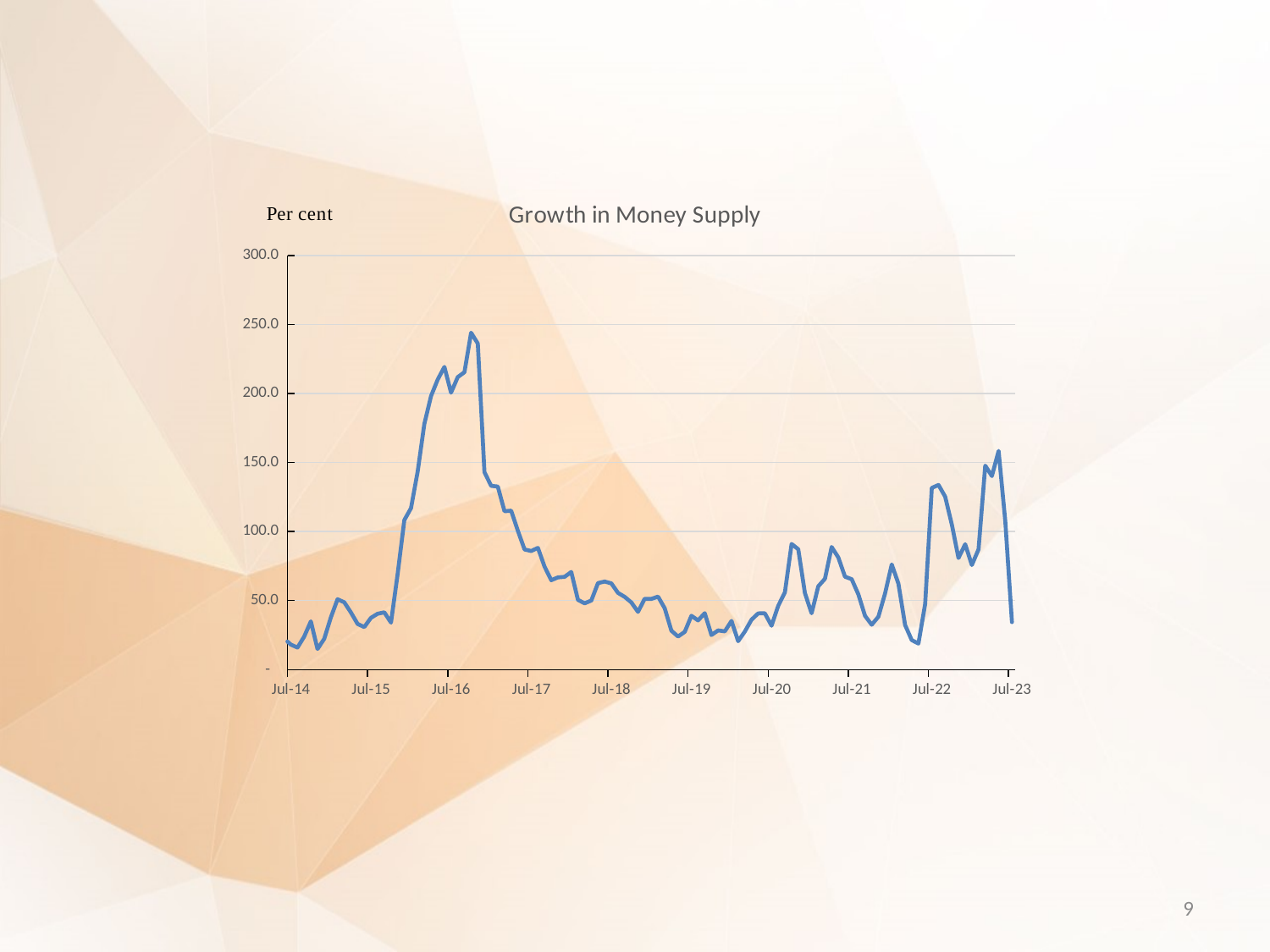
Is the value at Jul-19 greater or less than 50.0? less Is the highest point of the line greater or less than 250.0? less What is the title of the chart? Growth in Money Supply What kind of chart is shown on the slide? line chart Is the value at Jul-17 greater or less than 100.0? less What unit label is shown above the vertical axis of the chart? Per cent Which is larger, the value at Jul-16 or the value at Jul-22? Jul-16 Between which two x-axis labels does the line reach its highest point? Jul-16 and Jul-17 How many date labels are shown along the x axis of the chart? 10 Does the line generally rise or fall between Jul-16 and Jul-19? fall